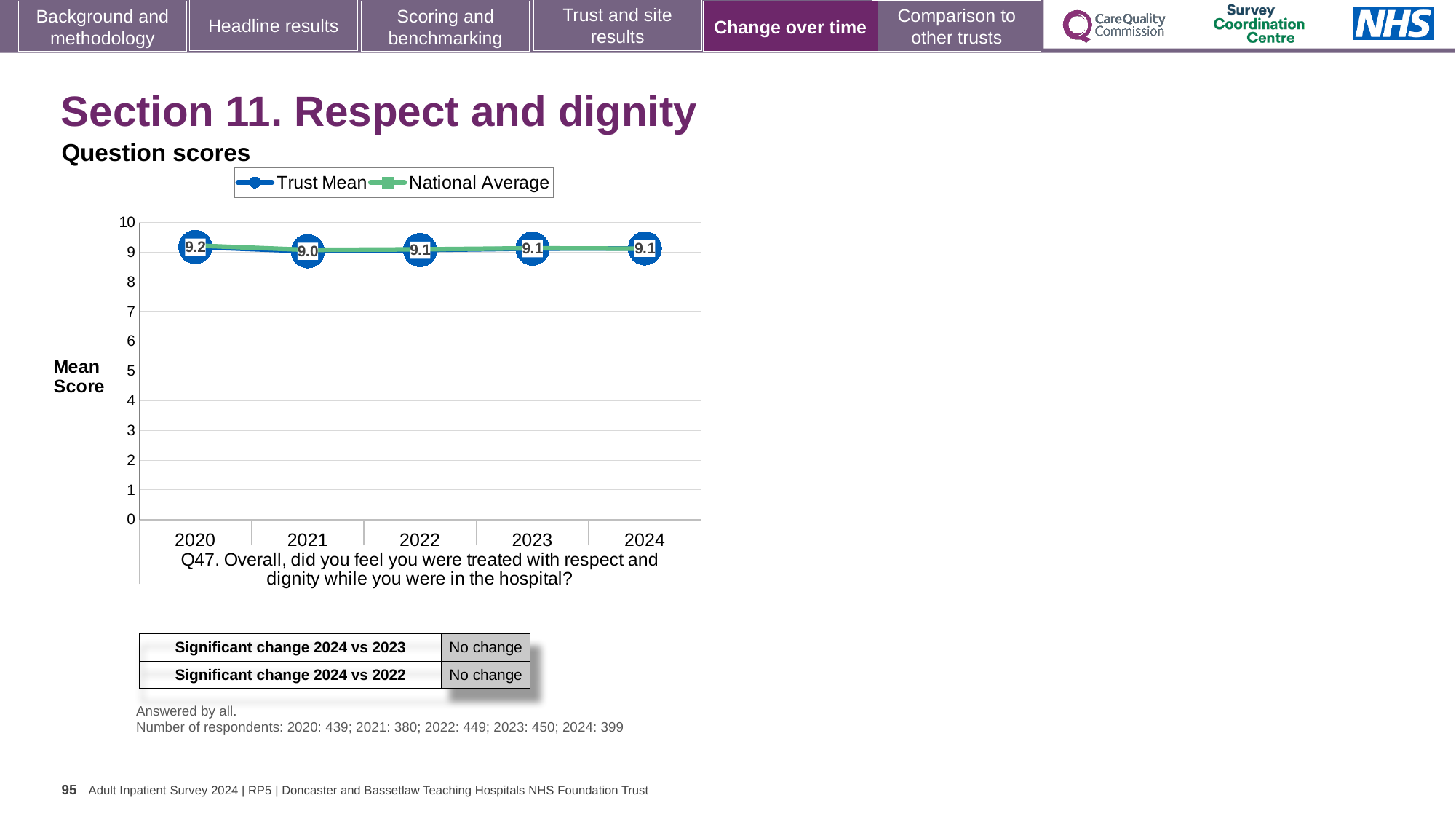
What is the Trust Mean value for 2020? 9.2 In which year is the Trust Mean lowest? 2021 What are the two series named in the legend? Trust Mean and National Average In which year is the Trust Mean highest? 2020 Which year has the larger Trust Mean, 2020 or 2021? 2020 What is the difference between the Trust Mean in 2020 and in 2021? 0.2 What kind of chart is shown? Line chart What is the Trust Mean value for 2021? 9.0 How many years are plotted on the x axis? 5 Is the National Average value for 2024 greater or less than 8? greater What is the Trust Mean value for 2024? 9.1 How many series does the legend list? 2